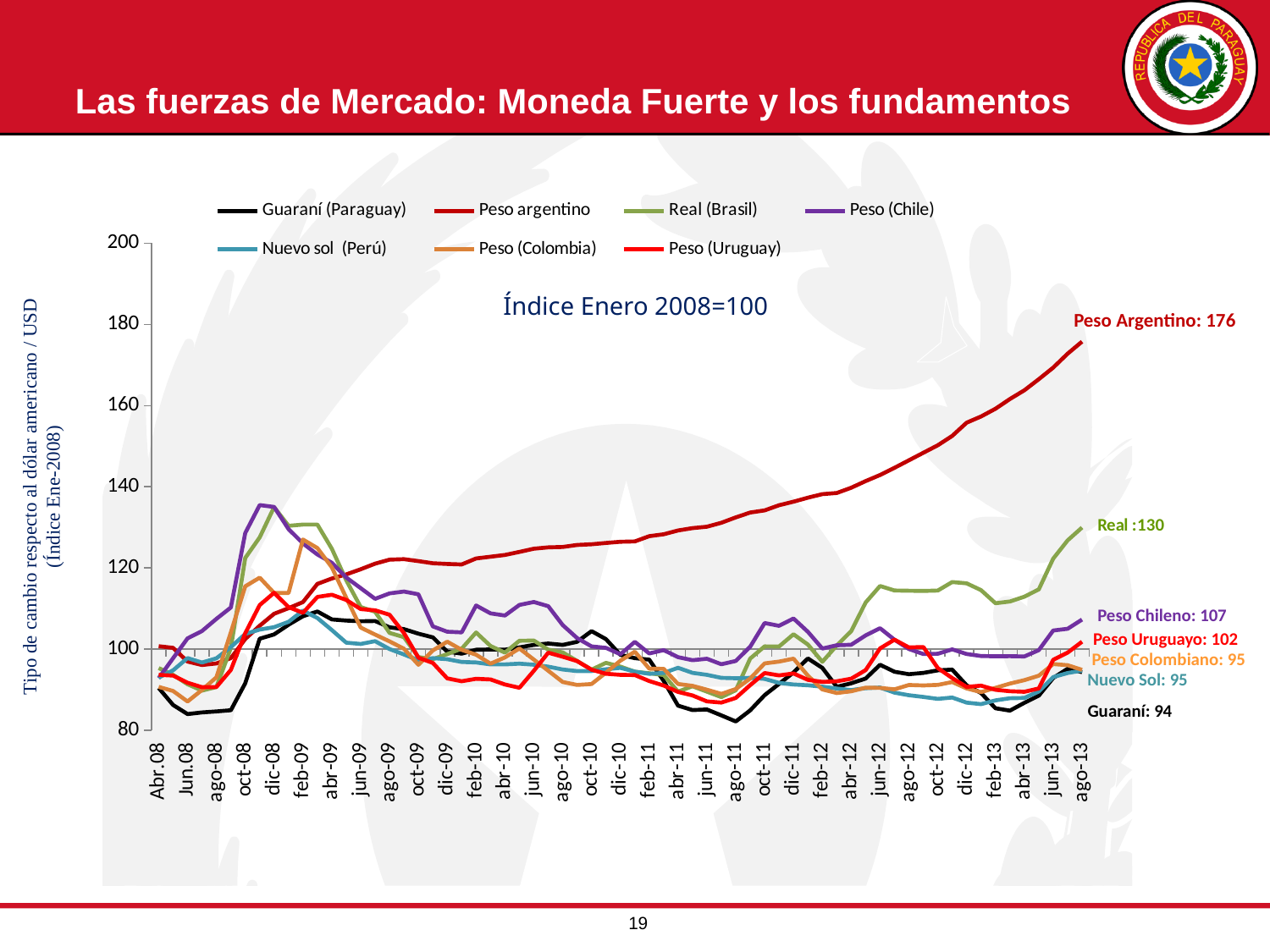
What type of chart is shown on the slide? line chart What is the final value shown for the Real (Brasil)? 130 What base period does the index use, according to the text on the chart? Enero 2008=100 Which currency has the highest index value at the end of the series (ago-13)? Peso Argentino Does the Peso Argentino line rise or fall over the period from 2010 to ago-13? rise What is the final value shown for the Peso Chileno? 107 What is the final value shown for the Peso Argentino in ago-13? 176 What is the difference between the final values of the Peso Argentino and the Real? 46 How many series does the legend list? 7 Which has a higher final value, the Peso Uruguayo or the Peso Colombiano? Peso Uruguayo Which currency has the lowest index value at the end of the series (ago-13)? Guaraní What is the final value shown for the Guaraní? 94